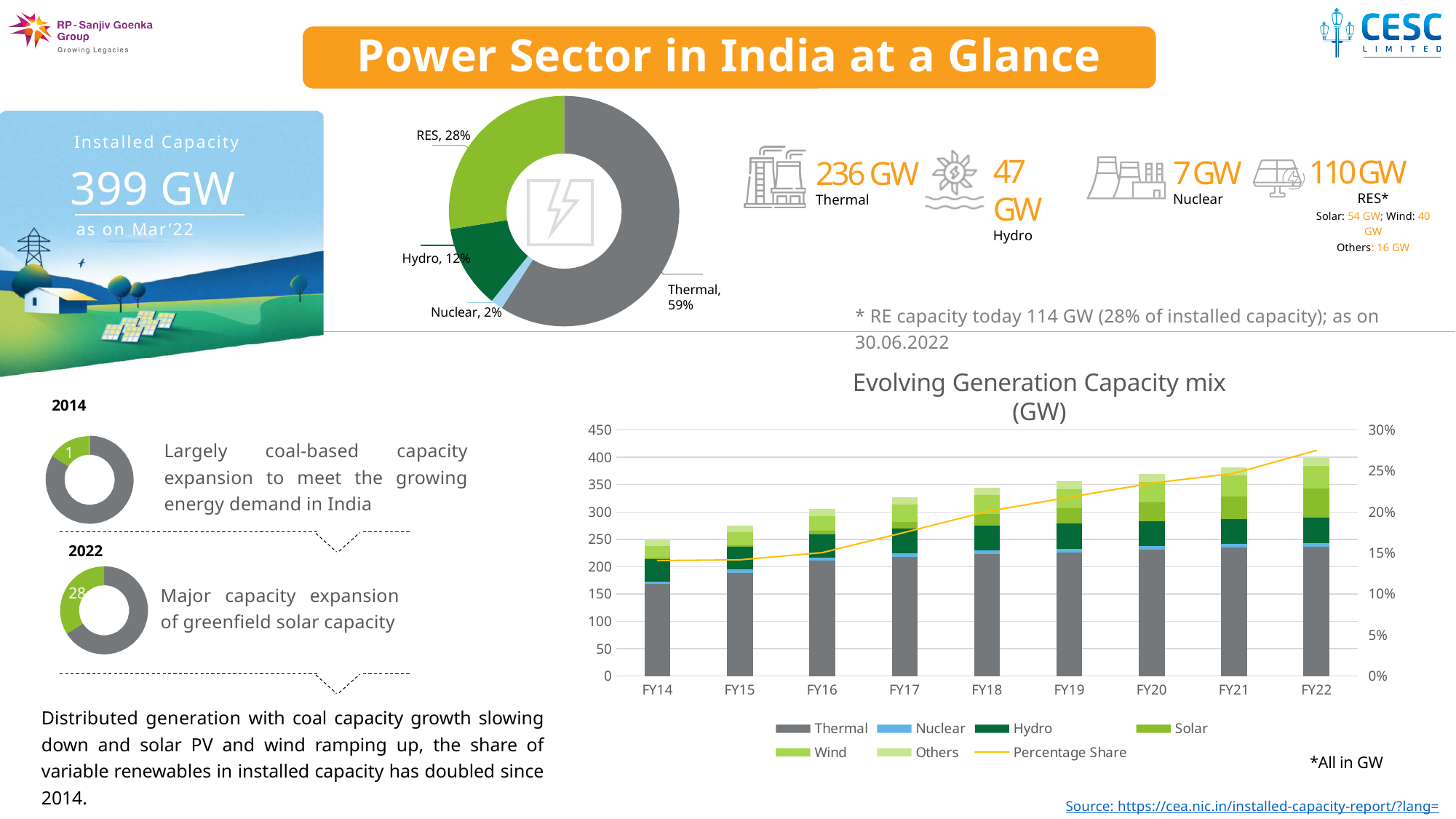
In the installed capacity donut chart, which segment is the smallest? Nuclear In the installed capacity donut chart, which segment is the largest? Thermal In the installed capacity donut chart, what share does Thermal have? 59% What kind of chart is 'Evolving Generation Capacity mix (GW)'? Stacked bar chart with a line In 'Evolving Generation Capacity mix (GW)', does the total capacity rise or fall from FY14 to FY22? Rise In the installed capacity donut chart, what is the difference between the RES share and the Hydro share? 16% How many segments does the installed capacity donut chart have? 4 How many fiscal years are shown on the x axis of 'Evolving Generation Capacity mix (GW)'? 9 In 'Evolving Generation Capacity mix (GW)', is the total stacked bar for FY22 greater or less than 350? greater How many entries does the legend of 'Evolving Generation Capacity mix (GW)' list? 7 In the small donut chart for 2022 on the left, what value is shown in the green segment? 28 In the installed capacity donut chart, what share does RES have? 28%